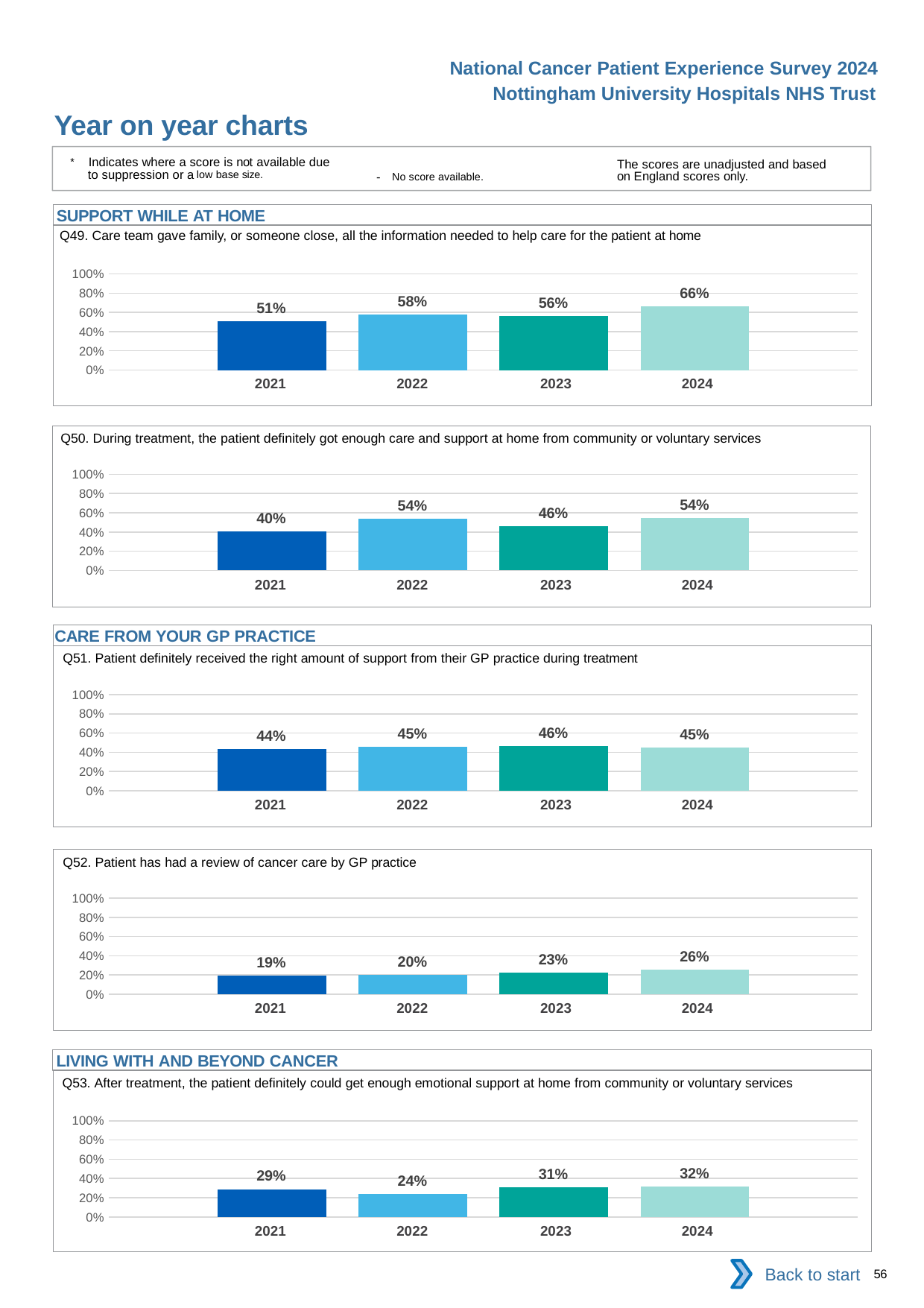
In the Q53 chart, what is the difference between the 2024 and 2022 values? 8% In the Q49 chart, what is the value for 2024? 66% In the Q51 chart, which year has the highest value? 2023 In the Q52 chart, do the values rise or fall from 2021 to 2024? rise What kind of chart is the Q50 chart? bar chart In the Q50 chart, what is the value for 2023? 46% In the Q52 chart, what is the value for 2021? 19% In the Q49 chart, which year has the lowest value? 2021 In the Q50 chart, what is the difference between the 2022 and 2021 values? 14% How many years are shown on the x axis of the Q49 chart? 4 In the Q51 chart, is the value for 2021 greater or less than 60%? less In the Q53 chart, which is larger, the value for 2022 or the value for 2023? 2023